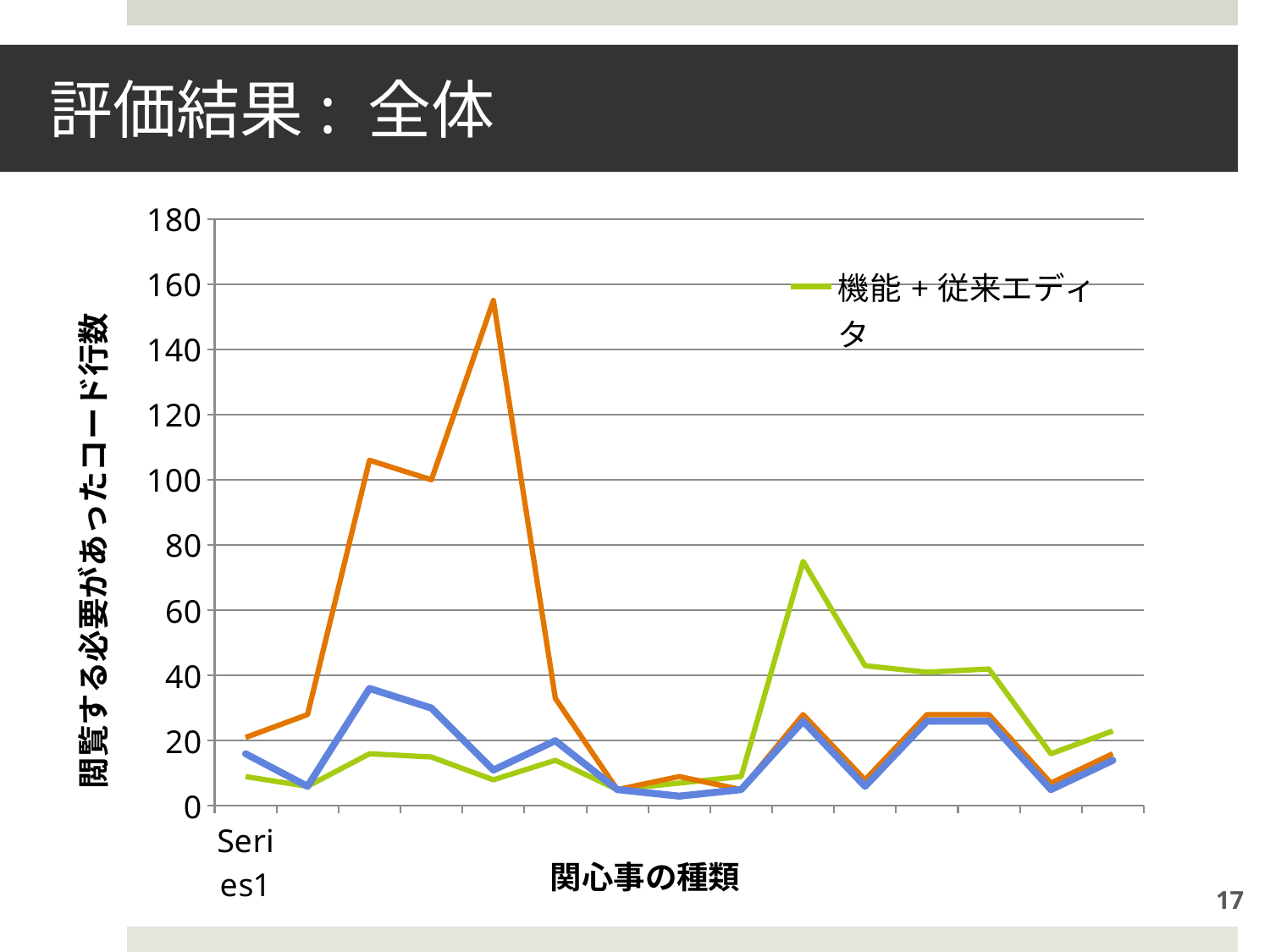
How many lines are plotted on the chart? 3 Is the value of the blue line at Series1 greater or less than 20? less Is the value of the green line (機能 + 従来エディタ) at Series1 greater or less than 20? less Which coloured line reaches the highest value on the chart? the orange line Is the peak value of the orange line greater or less than 140? greater What is the highest tick value shown on the vertical axis? 180 How many series does the chart's legend list? 1 What is the title of the vertical axis? 閲覧する必要があったコード行数 At Series1, which is larger: the value of the orange line or the value of the green line? the orange line What kind of chart is shown on the slide? line chart What is the legend entry shown in the chart? 機能 + 従来エディタ